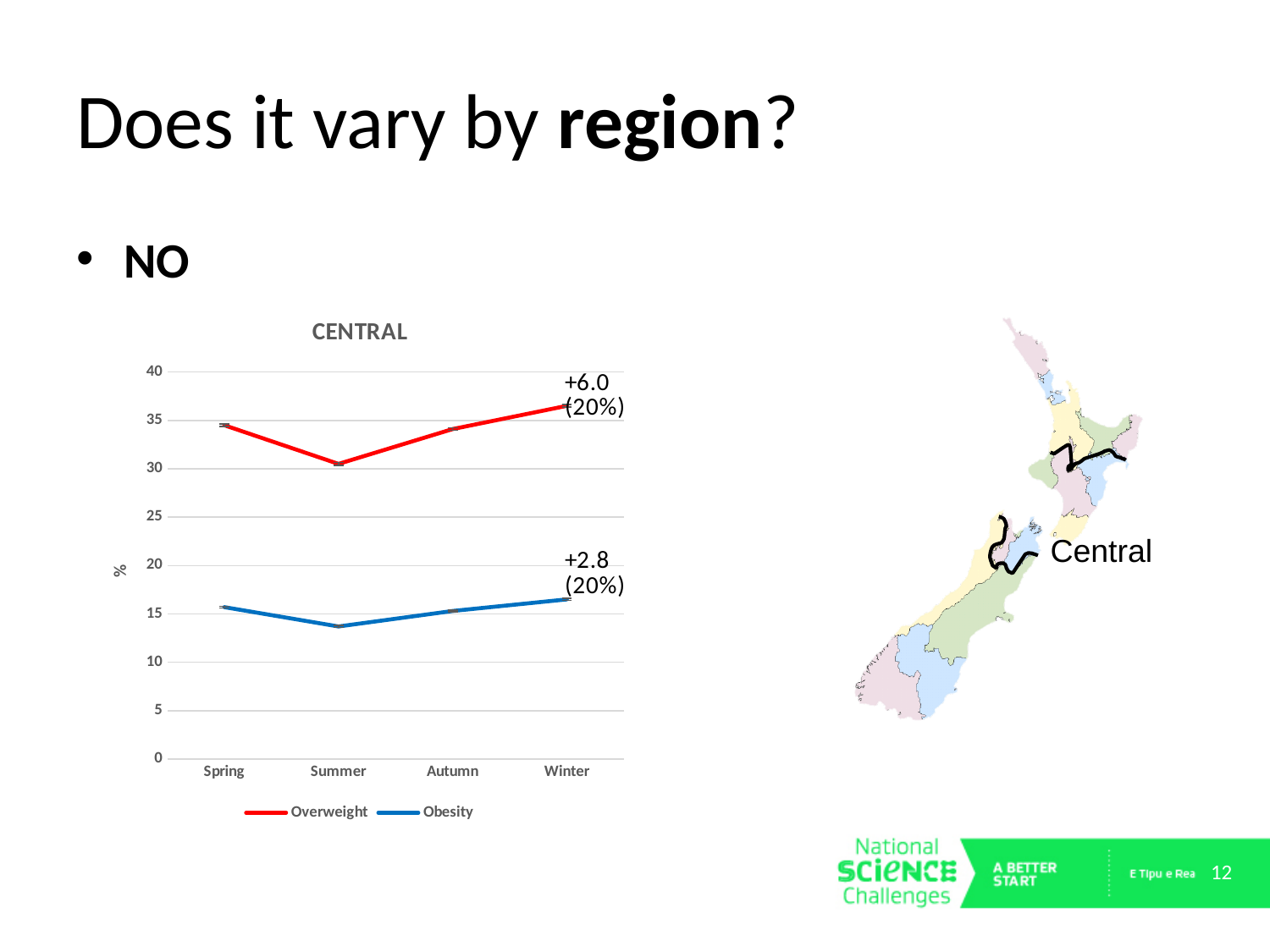
How many series does the chart's legend list? 2 Which is larger, the Overweight value for Spring or the Overweight value for Summer? Spring Do the Overweight values rise or fall from Summer to Winter? rise What is the title of the chart? CENTRAL Is the Obesity value for Summer greater or less than 15? less In which season is the Overweight value lowest? Summer Is the Overweight value for Summer greater or less than 35? less How many categories are shown on the x axis of the chart? 4 In which season is the Obesity value lowest? Summer What kind of chart is shown on the slide? line chart In which season is the Overweight value highest? Winter Which colour is used for the Overweight line in the chart? red